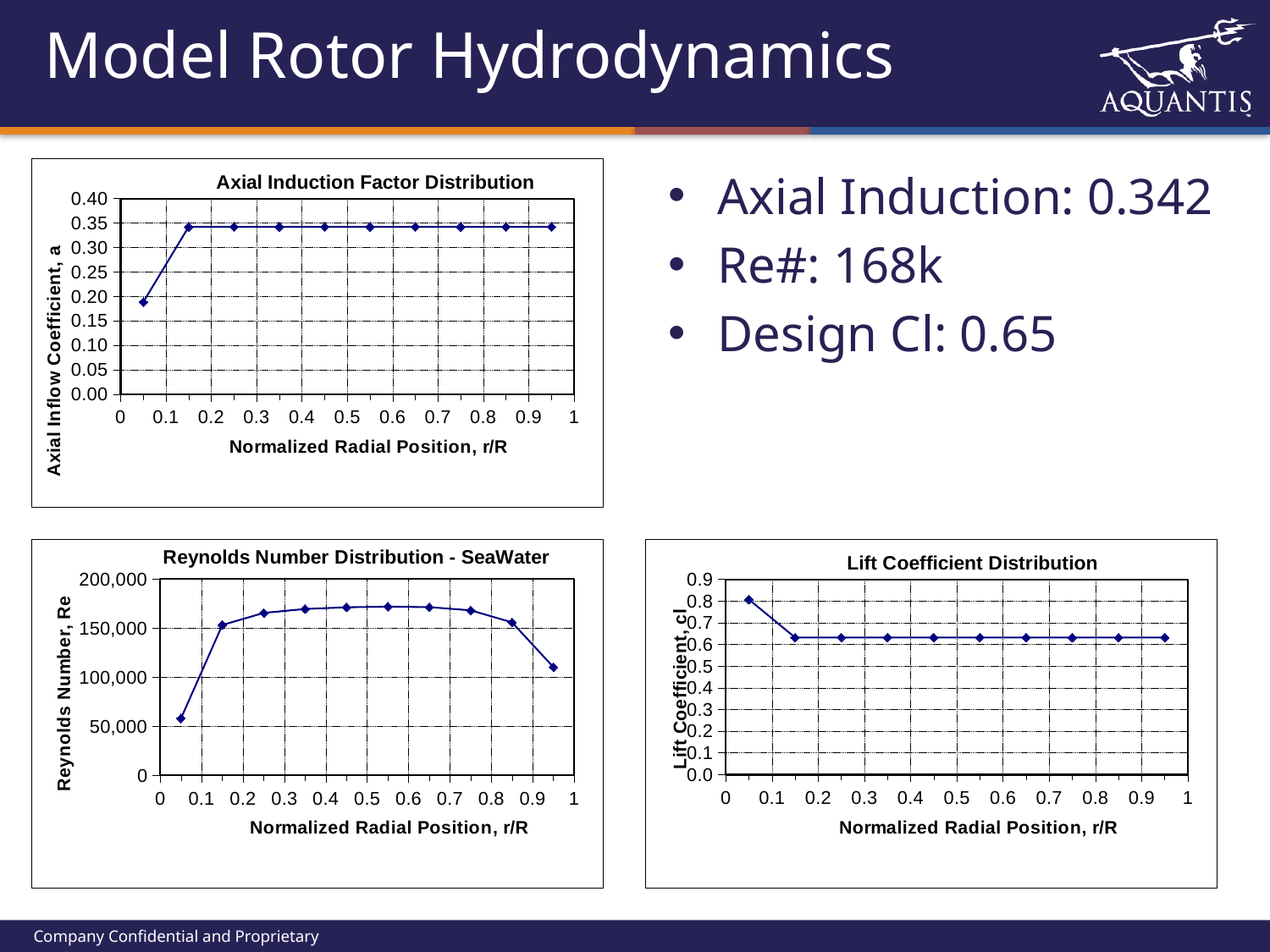
How many data points are plotted on the 'Reynolds Number Distribution - SeaWater' chart? 10 On the 'Axial Induction Factor Distribution' chart, is the value at r/R = 0.5 greater or less than 0.30? greater On the 'Reynolds Number Distribution - SeaWater' chart, is the value at r/R = 0.95 greater or less than 100,000? greater On the 'Axial Induction Factor Distribution' chart, how does the axial inflow coefficient change as r/R increases from 0.05 to 0.15? It rises On the 'Lift Coefficient Distribution' chart, is the value at r/R = 0.05 greater or less than 0.7? greater What kind of chart is the 'Axial Induction Factor Distribution' chart? line chart What is the x-axis label on the 'Lift Coefficient Distribution' chart? Normalized Radial Position, r/R On the 'Reynolds Number Distribution - SeaWater' chart, is the value at r/R = 0.05 larger or smaller than the value at r/R = 0.95? smaller On the 'Lift Coefficient Distribution' chart, at which normalized radial position is the lift coefficient highest? 0.05 On the 'Reynolds Number Distribution - SeaWater' chart, at which normalized radial position is the Reynolds number lowest? 0.05